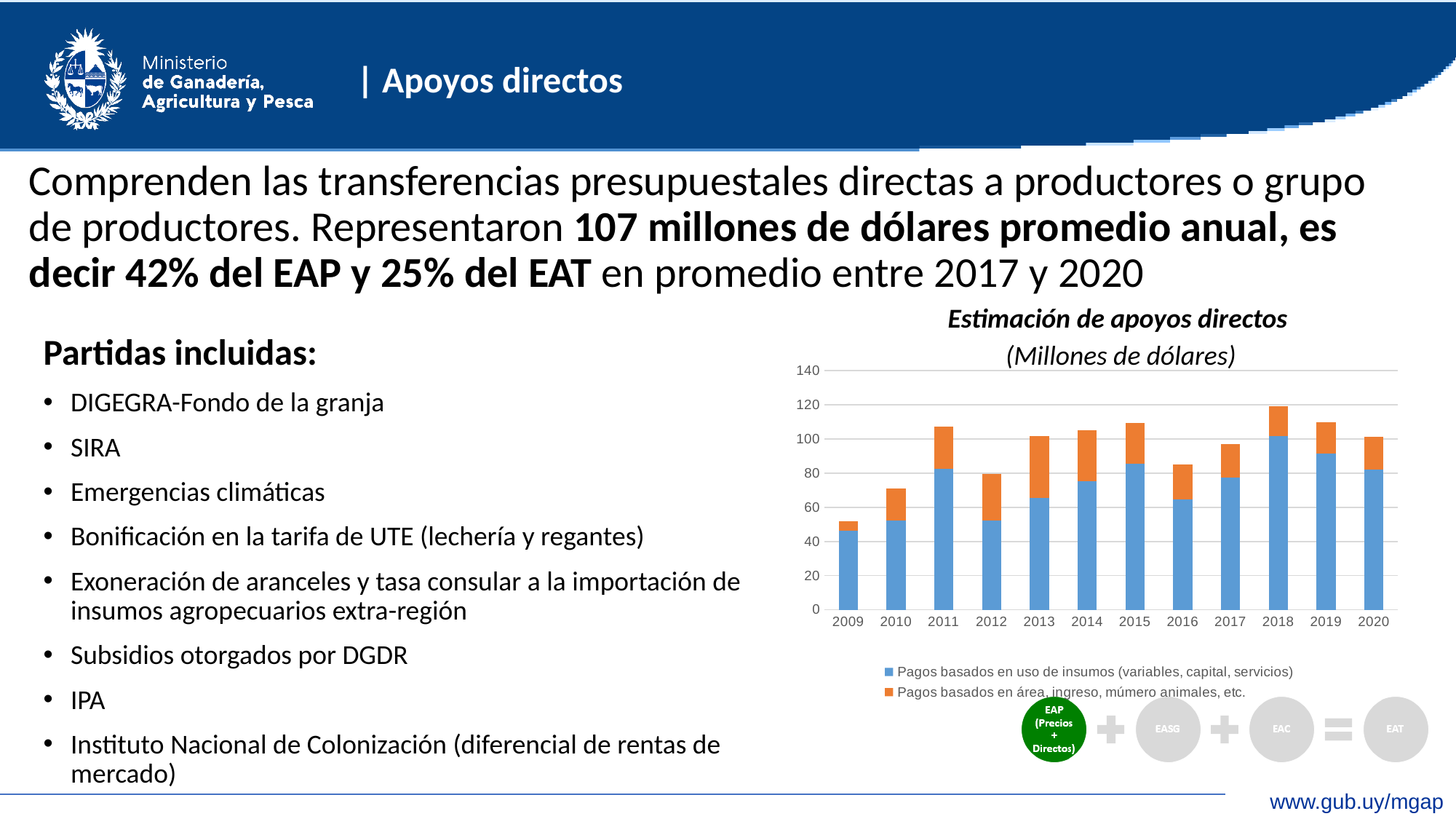
What kind of chart is shown on the slide? stacked bar chart Is the total value for 2016 greater or less than 100? less Which year has the lowest total bar in the chart? 2009 What is the title of the chart? Estimación de apoyos directos (Millones de dólares) Which year has the larger total bar, 2009 or 2018? 2018 Which year has the highest total bar in the chart? 2018 Is the total value for 2009 greater or less than 60? less How many years are shown on the x axis of the chart? 12 Is the total value for 2018 greater or less than 100? greater How many series does the chart legend list? 2 Do the total bars rise or fall from 2009 to 2011? rise